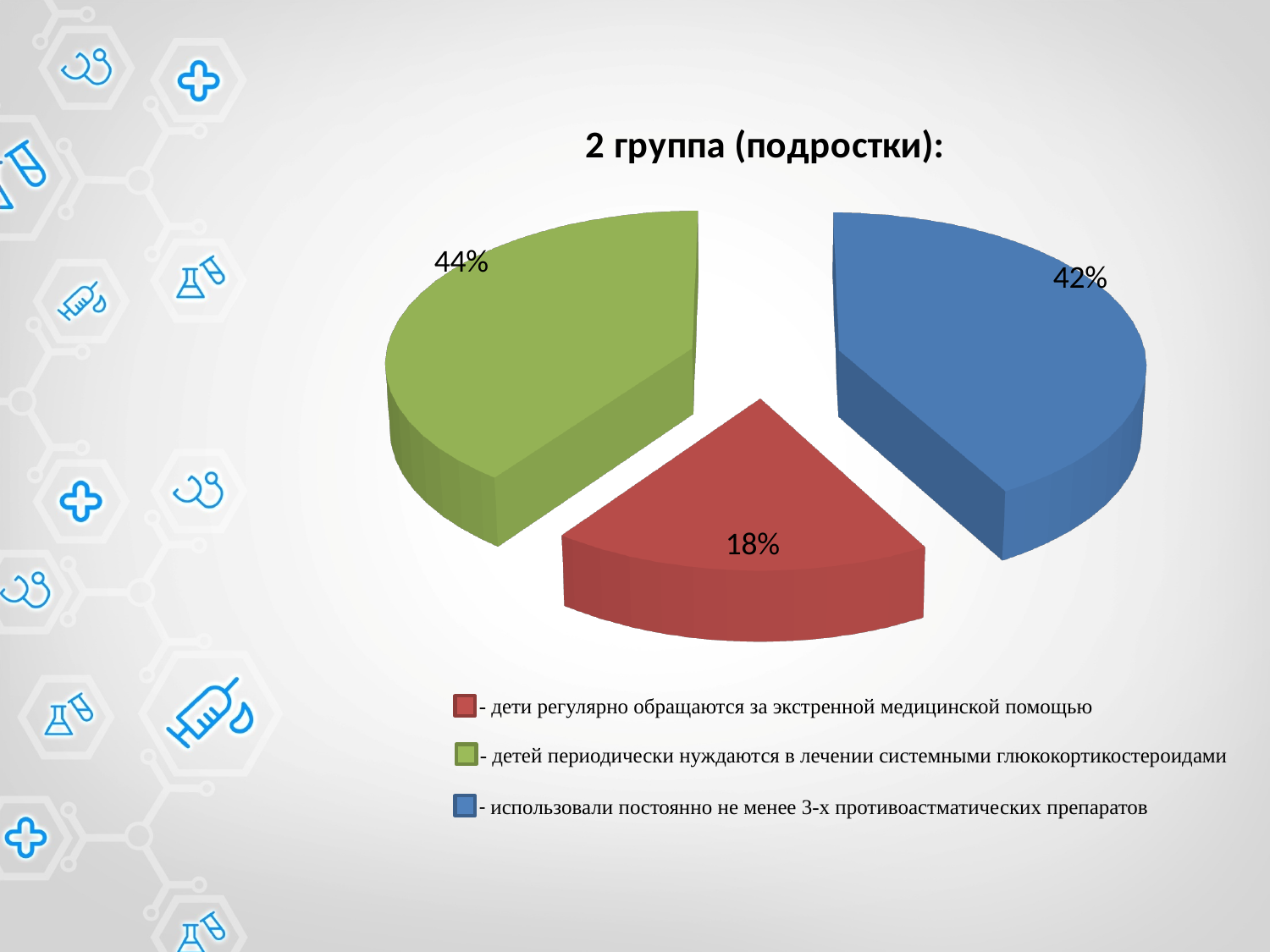
What type of chart is shown on the slide? Pie chart What percentage of the pie corresponds to 'детей периодически нуждаются в лечении системными глюкокортикостероидами'? 44% Which is larger: the share for 'использовали постоянно не менее 3-х противоастматических препаратов' or the share for 'дети регулярно обращаются за экстренной медицинской помощью'? использовали постоянно не менее 3-х противоастматических препаратов How many slices does the pie chart have? 3 Which category has the largest share of the pie? детей периодически нуждаются в лечении системными глюкокортикостероидами What percentage of the pie corresponds to 'дети регулярно обращаются за экстренной медицинской помощью'? 18% What percentage of the pie corresponds to 'использовали постоянно не менее 3-х противоастматических препаратов'? 42% What is the difference in percentage points between the green slice (44%) and the red slice (18%)? 26 What is the difference in percentage points between the blue slice (42%) and the red slice (18%)? 24 What colour is the slice representing 'дети регулярно обращаются за экстренной медицинской помощью'? Red What is the title of the chart? 2 группа (подростки): Which category has the smallest share of the pie? дети регулярно обращаются за экстренной медицинской помощью